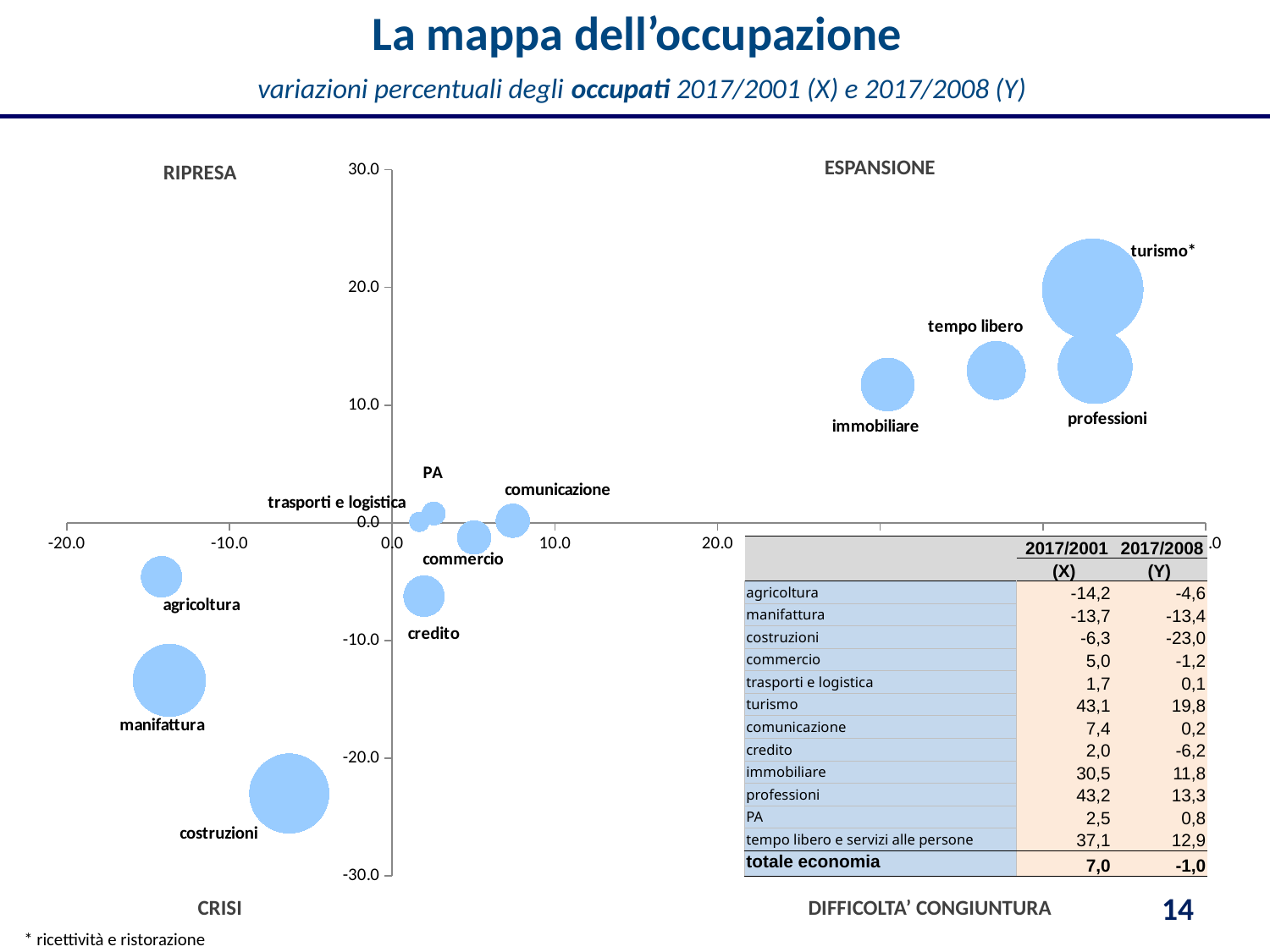
What is the 2017/2008 (Y) value for immobiliare in the table? 11,8 What is the difference between the 2017/2008 (Y) values of turismo and professioni? 6,5 Which sector has the highest 2017/2008 (Y) value? turismo According to the table, what is the 2017/2008 (Y) percentage change for costruzioni? -23,0 What kind of chart is shown on the slide? bubble chart Which has a larger 2017/2001 (X) value, commercio or comunicazione? comunicazione How many sector bubbles are plotted on the chart? 12 What label appears in the upper-right quadrant of the chart? ESPANSIONE What is the 2017/2001 (X) value for totale economia? 7,0 Is the Y value for the immobiliare bubble greater or less than 10.0? greater Which sector has the lowest 2017/2008 (Y) value? costruzioni According to the table, what is the 2017/2001 (X) percentage change in employment for turismo? 43,1